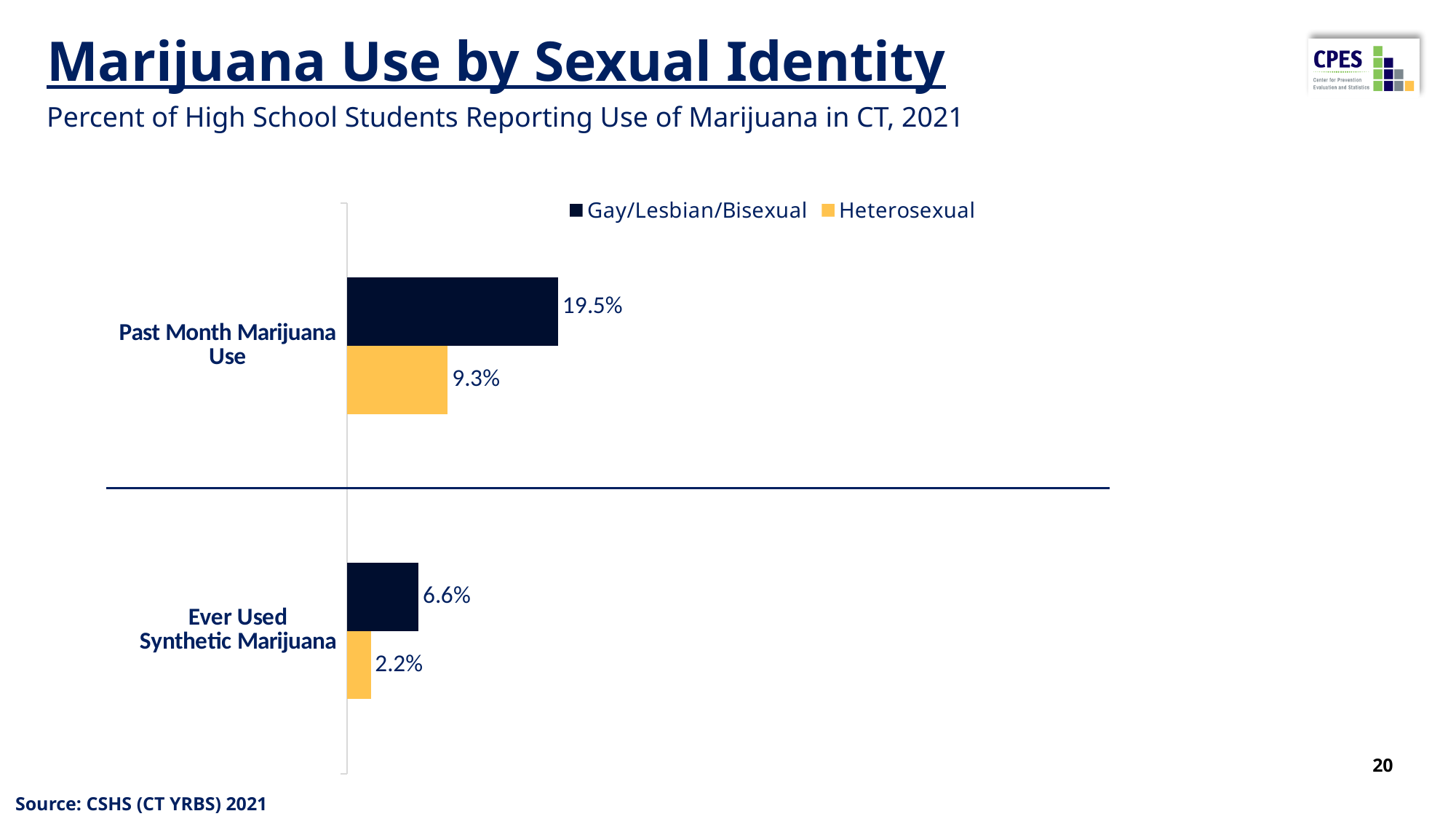
Which bar on the chart has the lowest value? Heterosexual, Ever Used Synthetic Marijuana What is the difference in percentage points between Gay/Lesbian/Bisexual and Heterosexual students for Past Month Marijuana Use? 10.2 Which bar on the chart has the highest value? Gay/Lesbian/Bisexual, Past Month Marijuana Use What percent of Gay/Lesbian/Bisexual students reported having Ever Used Synthetic Marijuana? 6.6% What percent of Gay/Lesbian/Bisexual students reported Past Month Marijuana Use? 19.5% How many categories are shown on the chart? 2 Which group has the larger value for Ever Used Synthetic Marijuana, Gay/Lesbian/Bisexual or Heterosexual? Gay/Lesbian/Bisexual How many series does the legend list? 2 What percent of Heterosexual students reported having Ever Used Synthetic Marijuana? 2.2% What kind of chart is shown on the slide? Bar chart What is the difference in percentage points between Gay/Lesbian/Bisexual and Heterosexual students for Ever Used Synthetic Marijuana? 4.4 What percent of Heterosexual students reported Past Month Marijuana Use? 9.3%